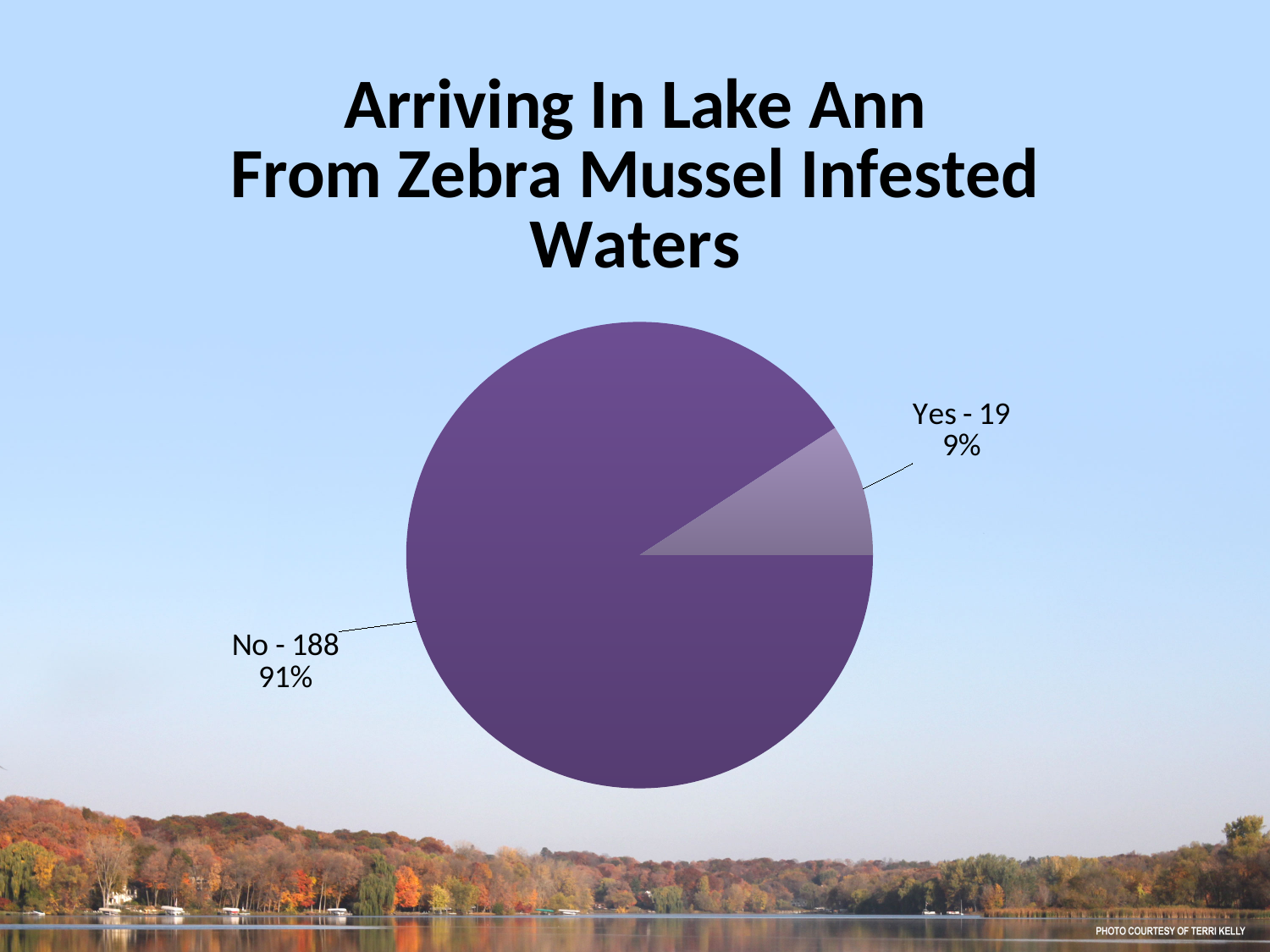
What kind of chart is shown on the slide? pie chart What percentage share does the "Yes" slice have? 9% What is the difference between the "No" count and the "Yes" count? 169 What is the total of the counts shown on the pie chart? 207 What is the title of the slide containing the pie chart? Arriving In Lake Ann From Zebra Mussel Infested Waters Which slice is the largest? No What percentage share does the "No" slice have? 91% What is the count for the "Yes" slice? 19 Which slice is the smallest? Yes How many slices does the pie chart have? 2 Which is larger, the "Yes" slice or the "No" slice? No What is the count for the "No" slice? 188